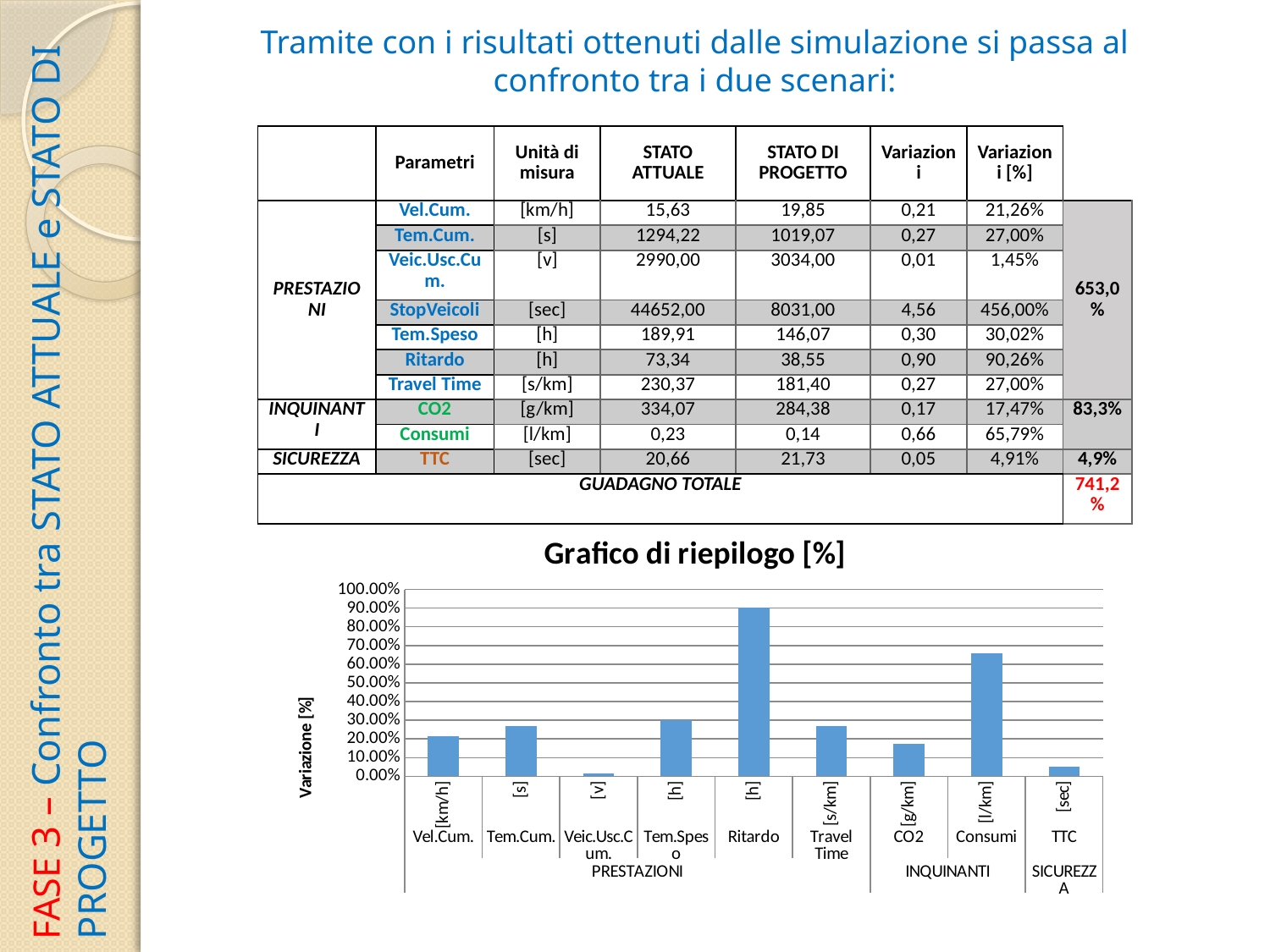
In the 'Grafico di riepilogo [%]' chart, which parameter has the lowest bar? Veic.Usc.Cum. In the 'Grafico di riepilogo [%]' chart, which is larger, the bar for CO2 or the bar for Travel Time? Travel Time In the 'Grafico di riepilogo [%]' chart, which parameter has the highest bar? Ritardo In the 'Grafico di riepilogo [%]' chart, is the value for Tem.Speso greater or less than 20.00%? greater How many bars are plotted in the 'Grafico di riepilogo [%]' chart? 9 What is the label of the vertical axis in the 'Grafico di riepilogo [%]' chart? Variazione [%] What kind of chart is the 'Grafico di riepilogo [%]' chart? bar chart In the 'Grafico di riepilogo [%]' chart, is the value for TTC greater or less than 10.00%? less In the 'Grafico di riepilogo [%]' chart, is the value for Consumi greater or less than 70.00%? less What is the title of the chart on the slide? Grafico di riepilogo [%] In the 'Grafico di riepilogo [%]' chart, which is larger, the bar for Consumi or the bar for Tem.Cum.? Consumi